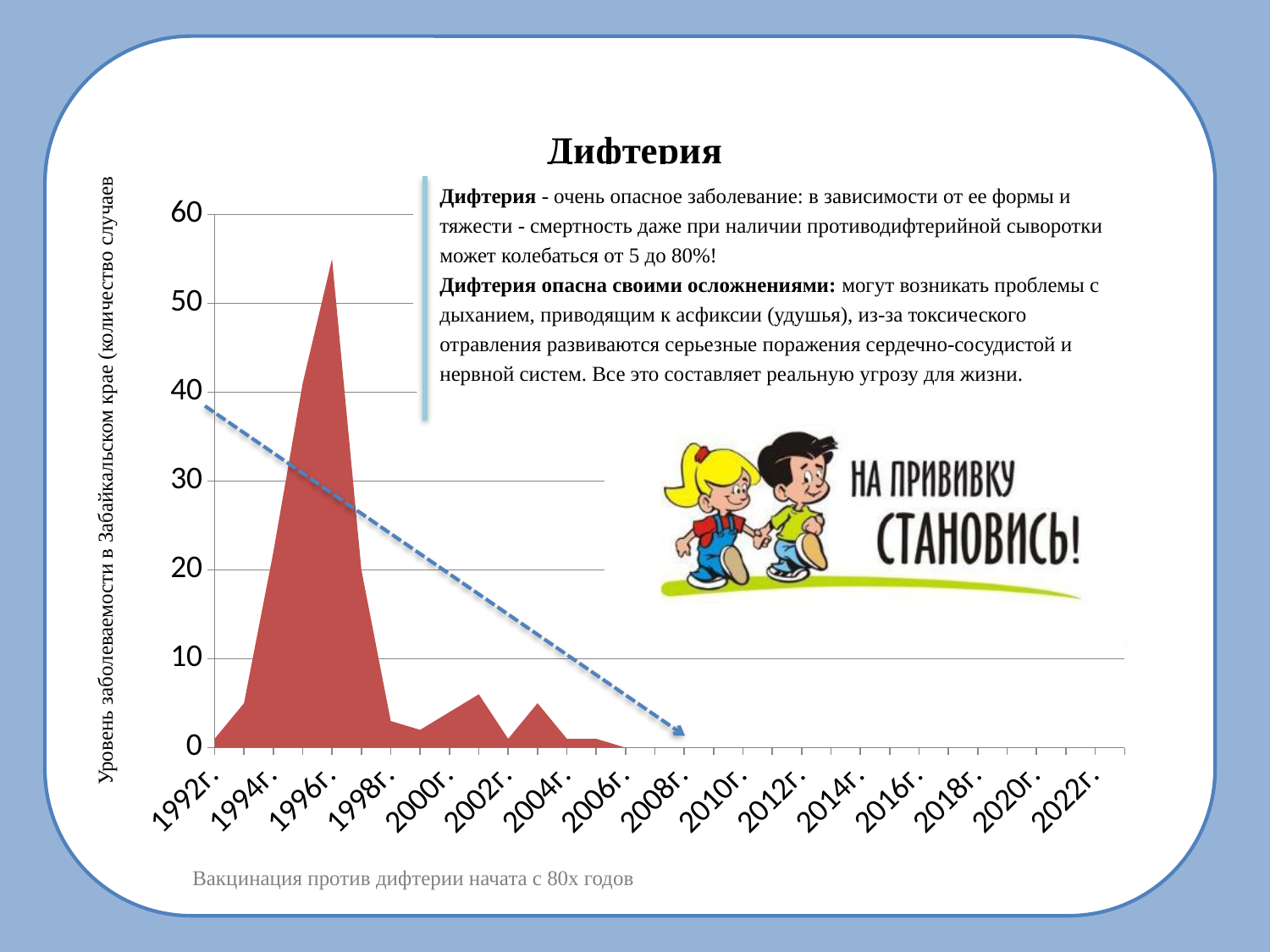
Is the value for 2010г. greater or less than 10? less Which year has the highest level of diphtheria incidence on the chart? 1996г. Is the value for 1996г. greater or less than 50? greater How many year labels are shown on the x axis? 16 Is the value for 2000г. greater or less than 10? less What is the title of the y axis? Уровень заболеваемости в Забайкальском крае (количество случаев) What kind of chart is shown on the slide? Area chart What is the highest tick value shown on the y axis? 60 Which is larger, the value for 1996г. or the value for 2002г.? 1996г. Does the incidence level generally rise or fall from 1996г. to 2022г.? Fall What is the first year label on the x axis? 1992г.